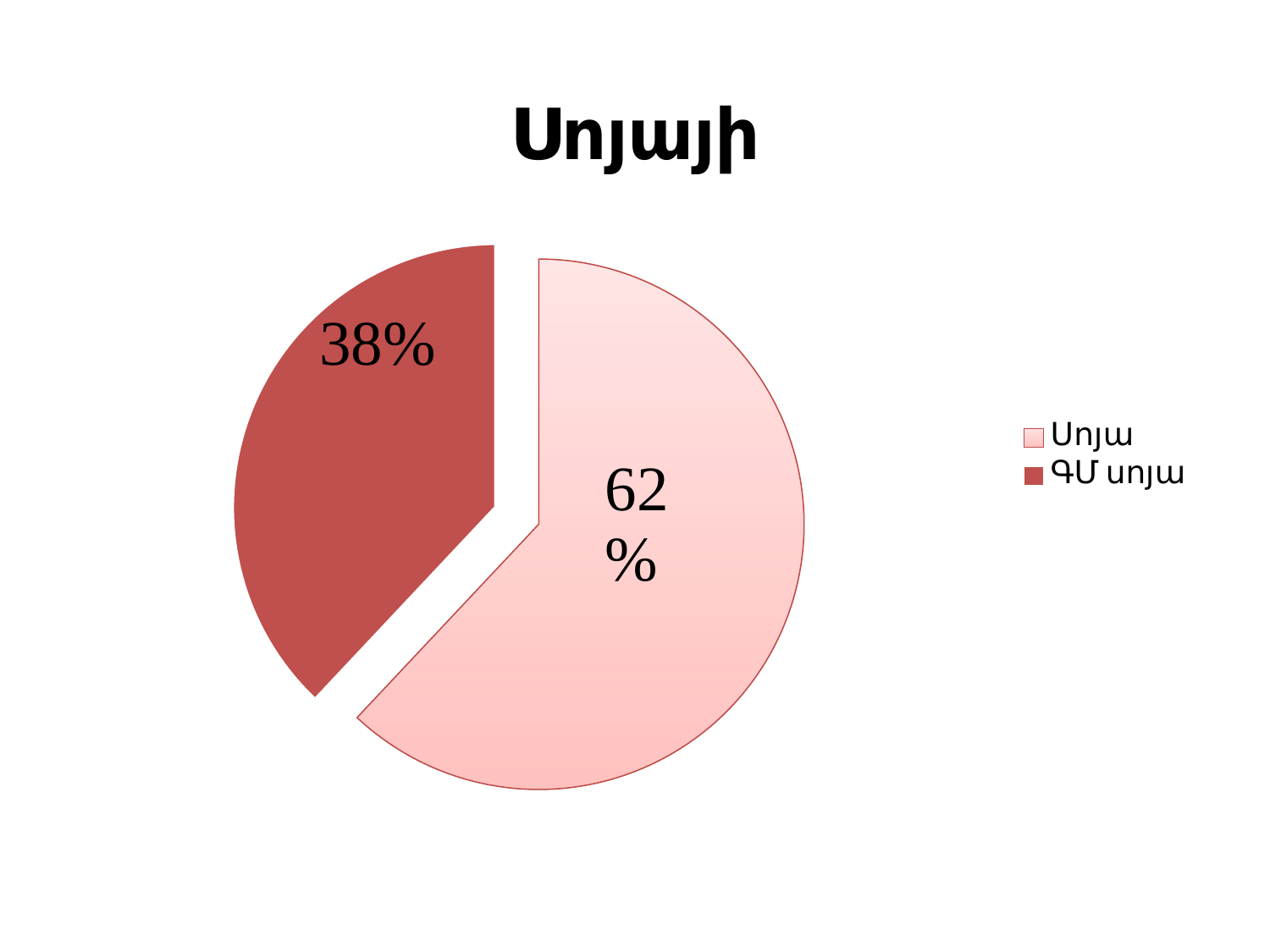
What share of the pie does Սոյա have? 62% Which slice is the largest? Սոյա Which slice is the smallest? ԳՄ սոյա What share of the pie does ԳՄ սոյա have? 38% What is the title of the chart? Սոյայի What is the difference in percentage points between the Սոյա and ԳՄ սոյա slices? 24 What kind of chart is shown on the slide? pie chart How many entries does the legend list? 2 Which legend entry is shown in the darker red colour? ԳՄ սոյա How many slices does the pie chart have? 2 Which is larger, the Սոյա slice or the ԳՄ սոյա slice? Սոյա